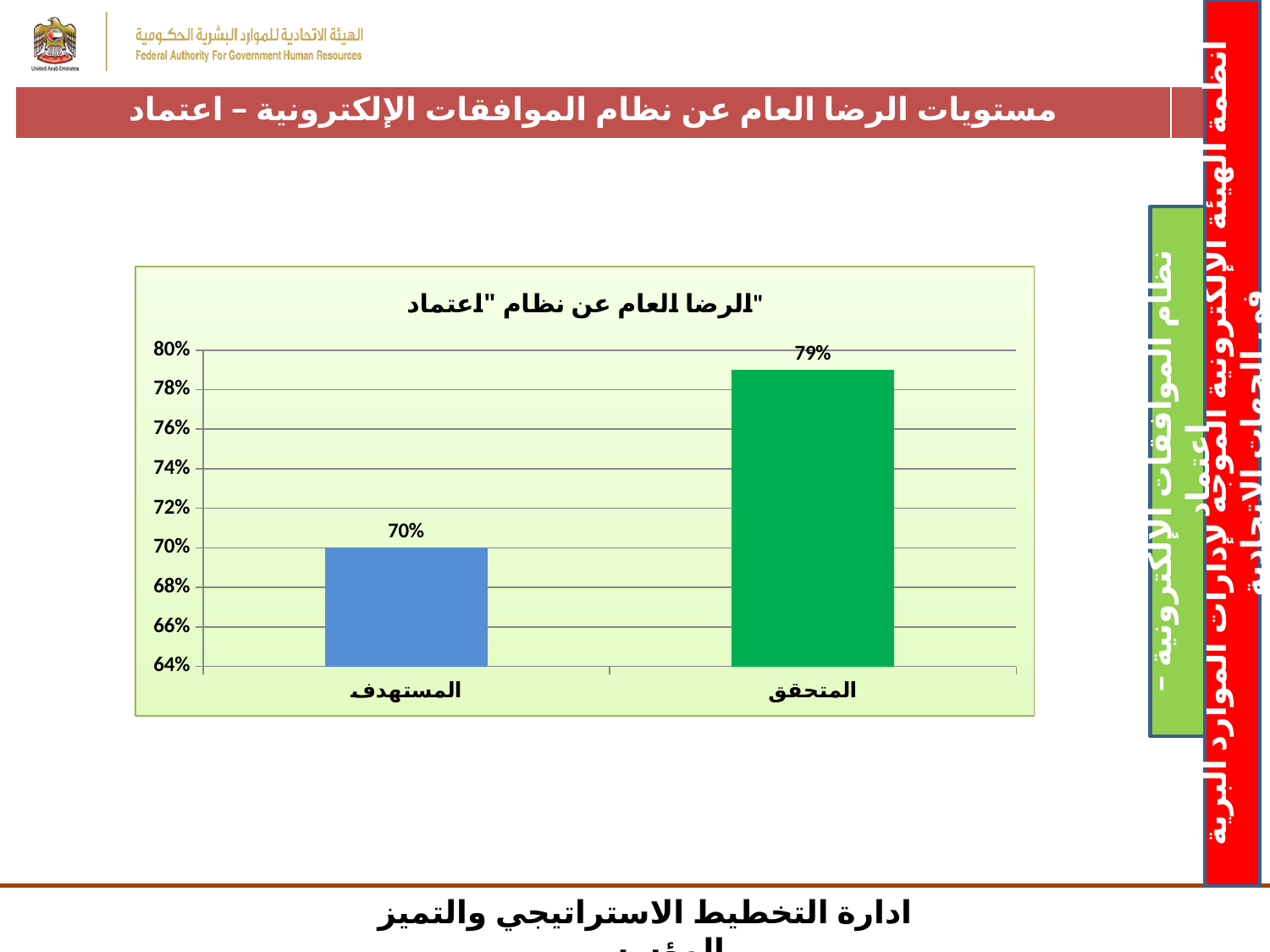
What is the difference between the value for المتحقق and the value for المستهدف? 9% Which category has the highest value? المتحقق Which category has the lowest value? المستهدف What is the value for المتحقق (achieved)? 79% What is the title of the chart? الرضا العام عن نظام "اعتماد" Is the value for المستهدف greater or less than 72%? less What colour is the bar for المتحقق? green What is the value for المستهدف (target)? 70% What kind of chart is shown on the slide? bar chart Which is larger, the value for المستهدف or the value for المتحقق? المتحقق How many categories are shown on the chart? 2 Is the value for المتحقق greater or less than 76%? greater